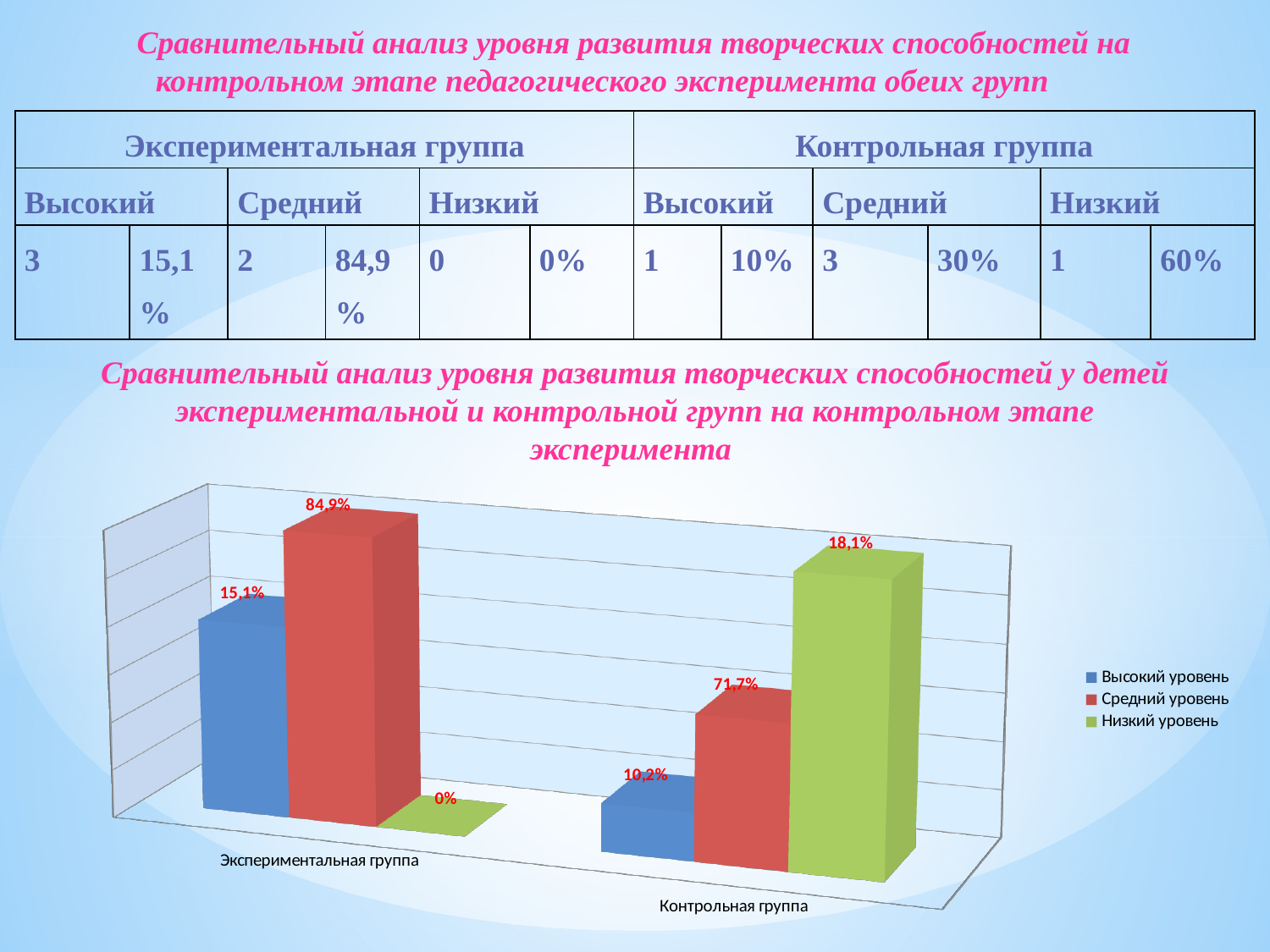
What is the value for Низкий уровень in the Экспериментальная группа? 0% How many series does the chart legend list? 3 What type of chart is shown on the slide? Bar chart Which group has the larger value for Высокий уровень? Экспериментальная группа What is the value for Средний уровень in the Экспериментальная группа? 84,9% What is the value for Низкий уровень in the Контрольная группа? 18,1% What is the value for Высокий уровень in the Контрольная группа? 10,2% Which level has the lowest value in the Экспериментальная группа? Низкий уровень What is the difference between Средний уровень and Высокий уровень in the Экспериментальная группа? 69,8% How many groups (categories) are shown on the x axis of the chart? 2 What is the difference between the Средний уровень values of the Экспериментальная группа and the Контрольная группа? 13,2%